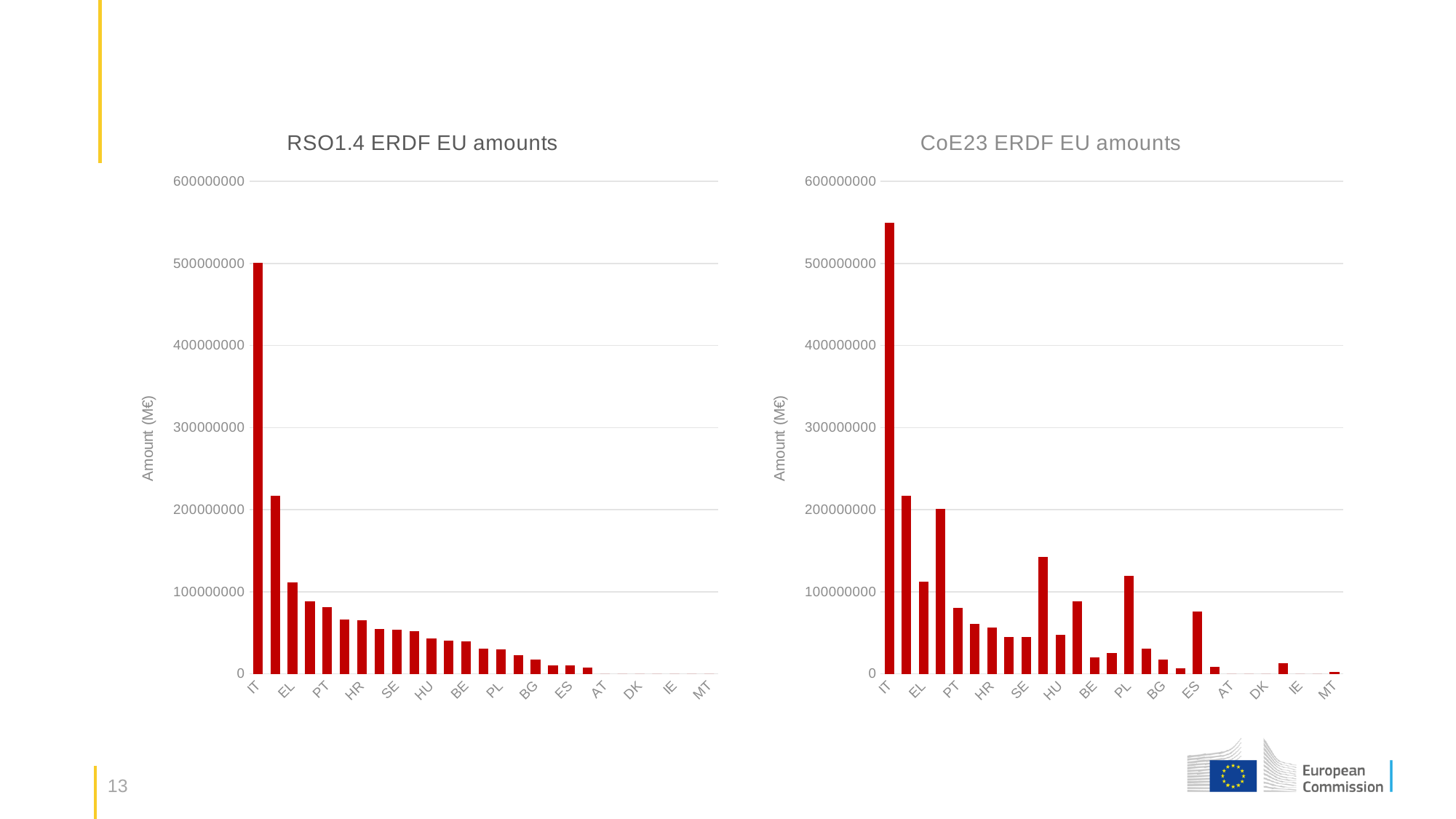
In the RSO1.4 ERDF EU amounts chart, is the value for IT greater or less than 400000000? greater In the CoE23 ERDF EU amounts chart, is the value for MT greater or less than 100000000? less What is the title of the chart on the left of the slide? RSO1.4 ERDF EU amounts Which is larger: the value for IT in the RSO1.4 ERDF EU amounts chart or the value for IT in the CoE23 ERDF EU amounts chart? CoE23 ERDF EU amounts In the RSO1.4 ERDF EU amounts chart, is the value for EL greater or less than 200000000? less In the RSO1.4 ERDF EU amounts chart, which of IT or EL has the larger value? IT What kind of chart is the RSO1.4 ERDF EU amounts chart? bar chart In the RSO1.4 ERDF EU amounts chart, which category has the highest value? IT In the RSO1.4 ERDF EU amounts chart, do the values generally rise or fall from left to right along the x axis? fall In the CoE23 ERDF EU amounts chart, which category has the highest value? IT What is the y-axis title of the CoE23 ERDF EU amounts chart? Amount (M€)